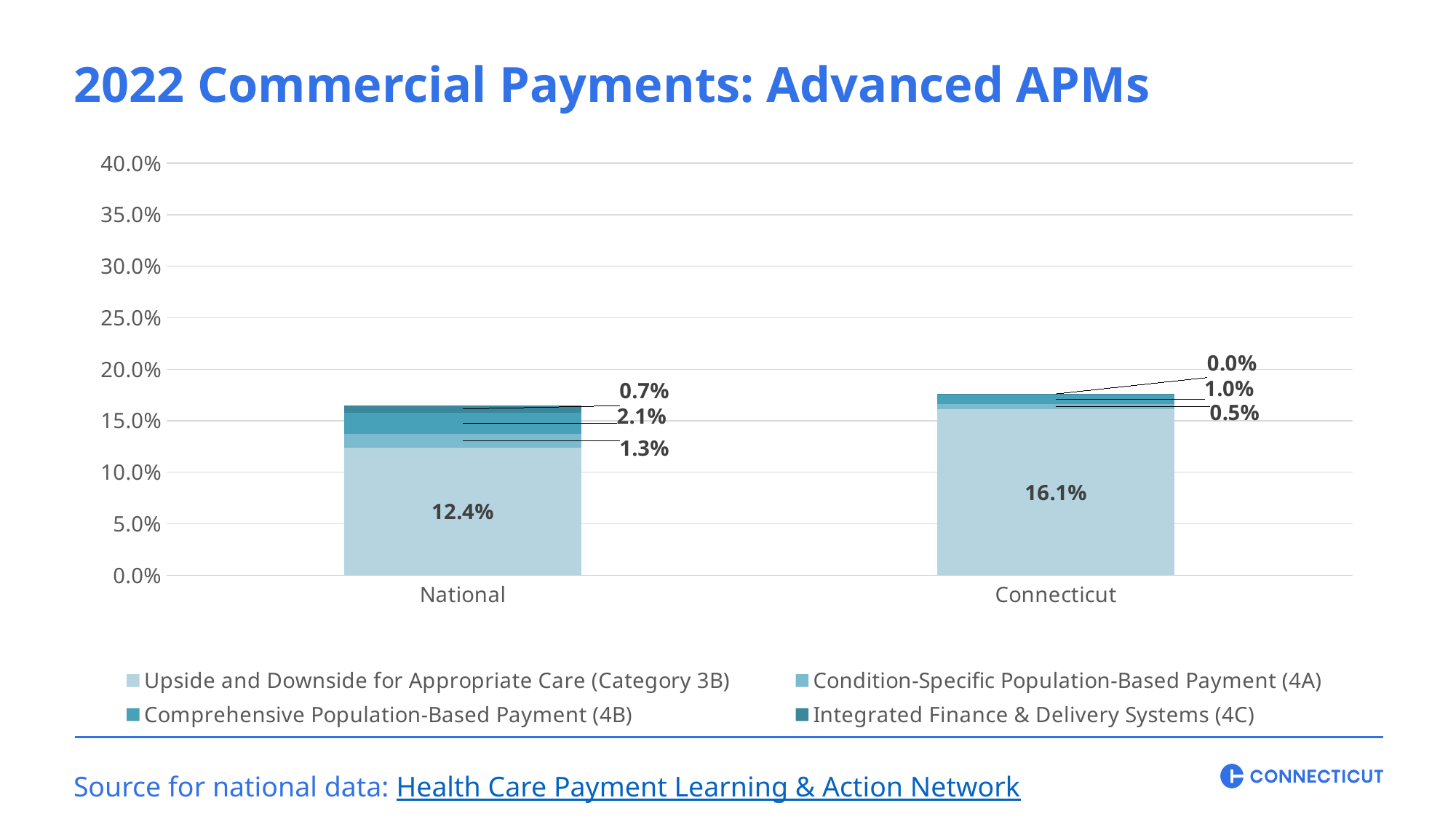
What type of chart is shown on the slide? Stacked bar chart How many series does the legend list? 4 What is the value of Condition-Specific Population-Based Payment (4A) for Connecticut? 0.5% What is the difference between the Category 3B values for Connecticut and National? 3.7% What is the value of Upside and Downside for Appropriate Care (Category 3B) for National? 12.4% What is the value of Upside and Downside for Appropriate Care (Category 3B) for Connecticut? 16.1% What is the value of Comprehensive Population-Based Payment (4B) for National? 2.1% What is the title of the chart? 2022 Commercial Payments: Advanced APMs How many categories are shown on the x axis? 2 Which has the larger Comprehensive Population-Based Payment (4B) value, National or Connecticut? National What is the total of the stacked bar for National? 16.5% What is the value of Integrated Finance & Delivery Systems (4C) for Connecticut? 0.0%